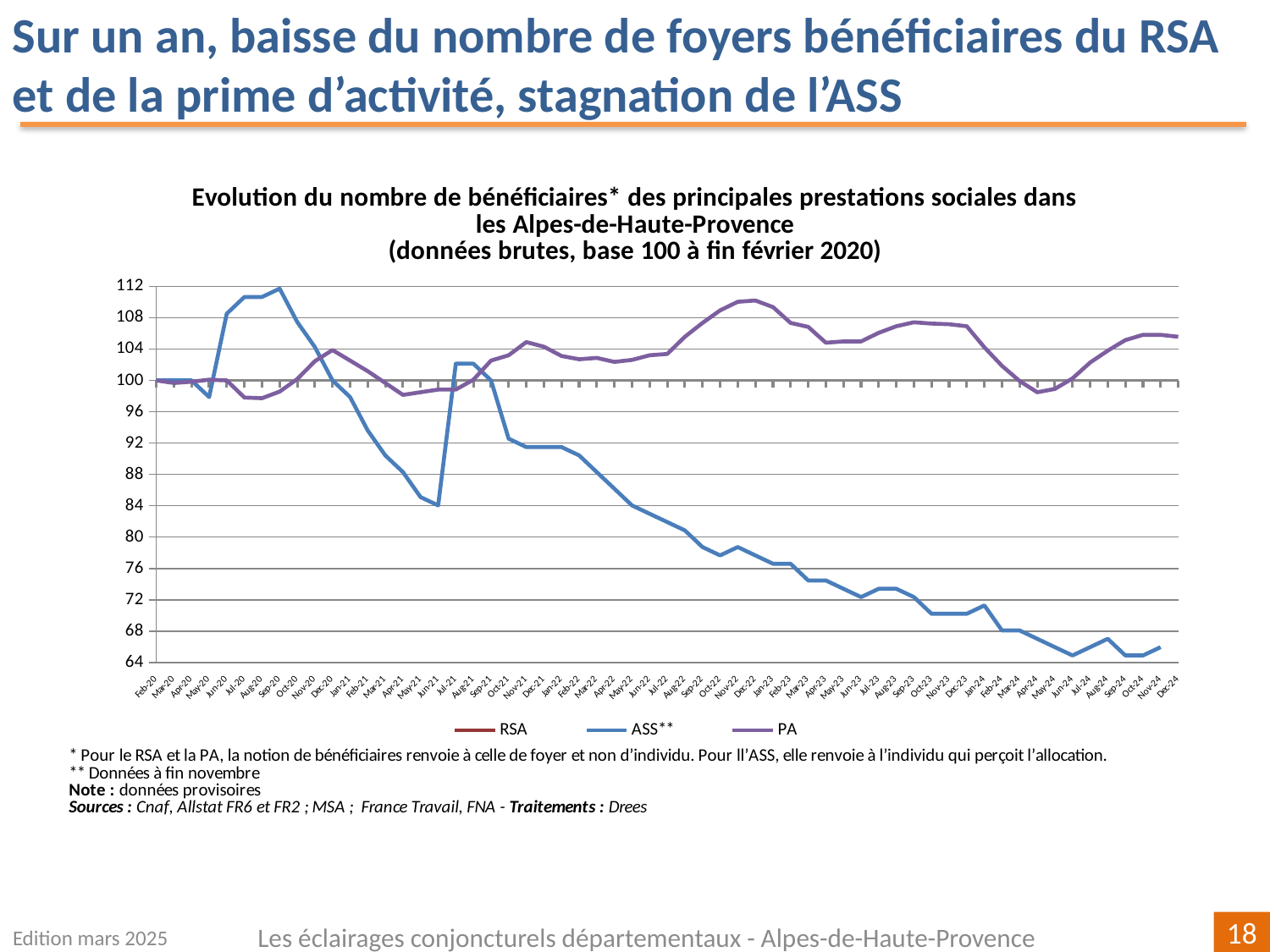
How many series does the legend list? 3 Is the value of the PA series at Apr-24 greater or less than 100? less Is the value of the PA series at Dec-22 greater or less than 108? greater Does the PA series overall rise or fall between Feb-20 and Dec-24? rise What is the base period of the index (base 100) according to the chart title? fin février 2020 Is the value of the ASS** series at Jun-21 greater or less than 88? less Which series are listed in the legend? RSA, ASS**, PA What kind of chart is shown on the slide? line chart